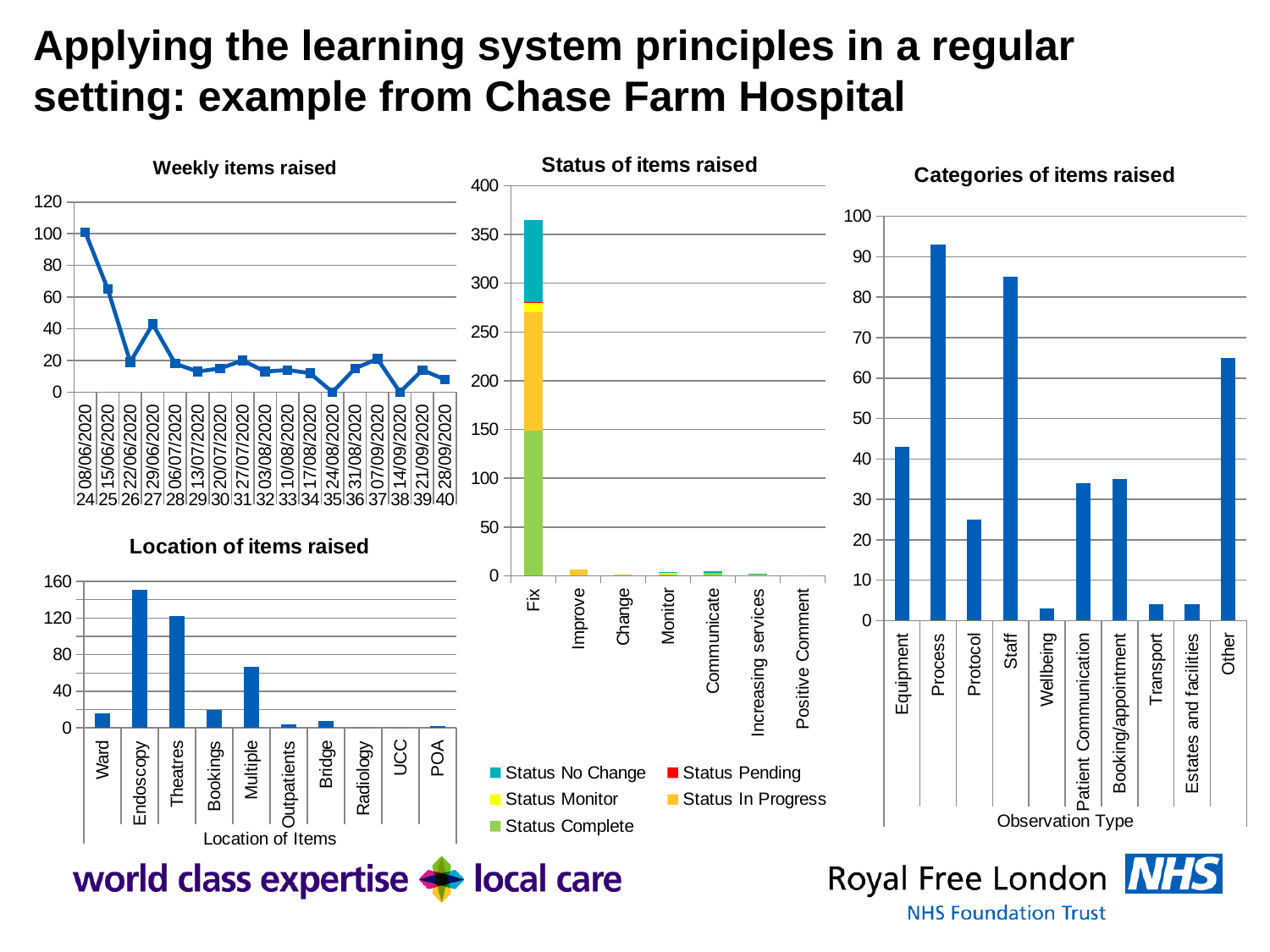
In the 'Categories of items raised' chart, which category has the highest value? Process In the 'Location of items raised' chart, is the value for Multiple greater or less than 40? greater In the 'Weekly items raised' chart, which date has the highest value? 08/06/2020 In the 'Status of items raised' chart, which status category has the tallest bar? Fix In the 'Status of items raised' chart, how many series does the legend list? 5 In the 'Weekly items raised' chart, is the value for 08/06/2020 greater or less than 80? greater In the 'Location of items raised' chart, how many locations are shown on the x axis? 10 In the 'Categories of items raised' chart, what is the x-axis title? Observation Type In the 'Categories of items raised' chart, is the value for Protocol greater or less than 30? less In the 'Weekly items raised' chart, do the values generally rise or fall from 08/06/2020 to 28/09/2020? fall What kind of chart is the 'Weekly items raised' chart? line chart